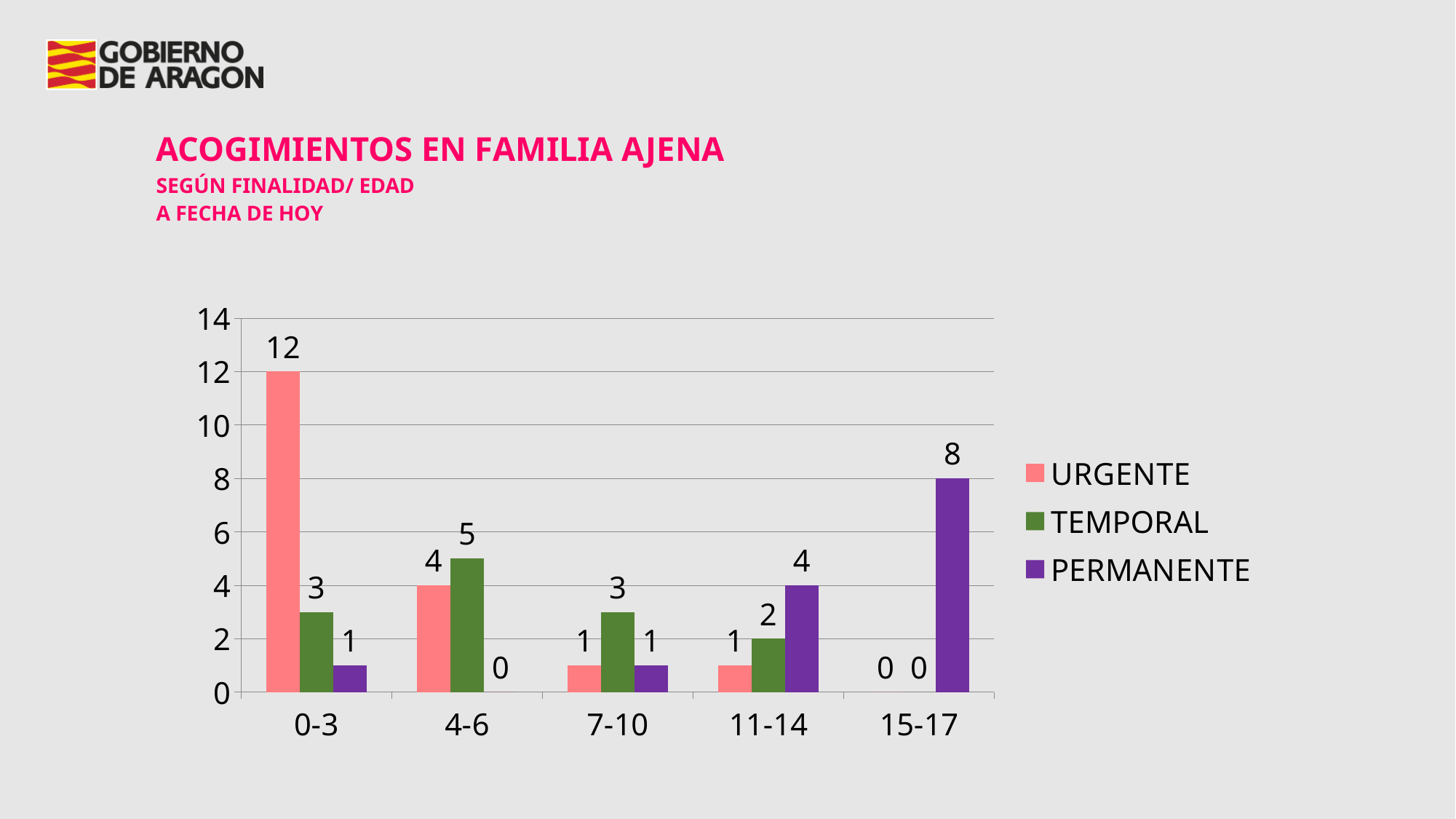
What kind of chart is shown on the slide? Bar chart How many series does the legend list? 3 What is the difference between the URGENTE value for 0-3 and the URGENTE value for 4-6? 8 What is the URGENTE value for the 0-3 age group? 12 Which is larger for the 7-10 age group, TEMPORAL or PERMANENTE? TEMPORAL Which series is shown in purple in the legend? PERMANENTE Which age group has the highest URGENTE value? 0-3 What is the TEMPORAL value for the 4-6 age group? 5 What is the PERMANENTE value for the 11-14 age group? 4 Which age group has the lowest TEMPORAL value? 15-17 How many age groups are shown on the x axis? 5 What is the PERMANENTE value for the 15-17 age group? 8